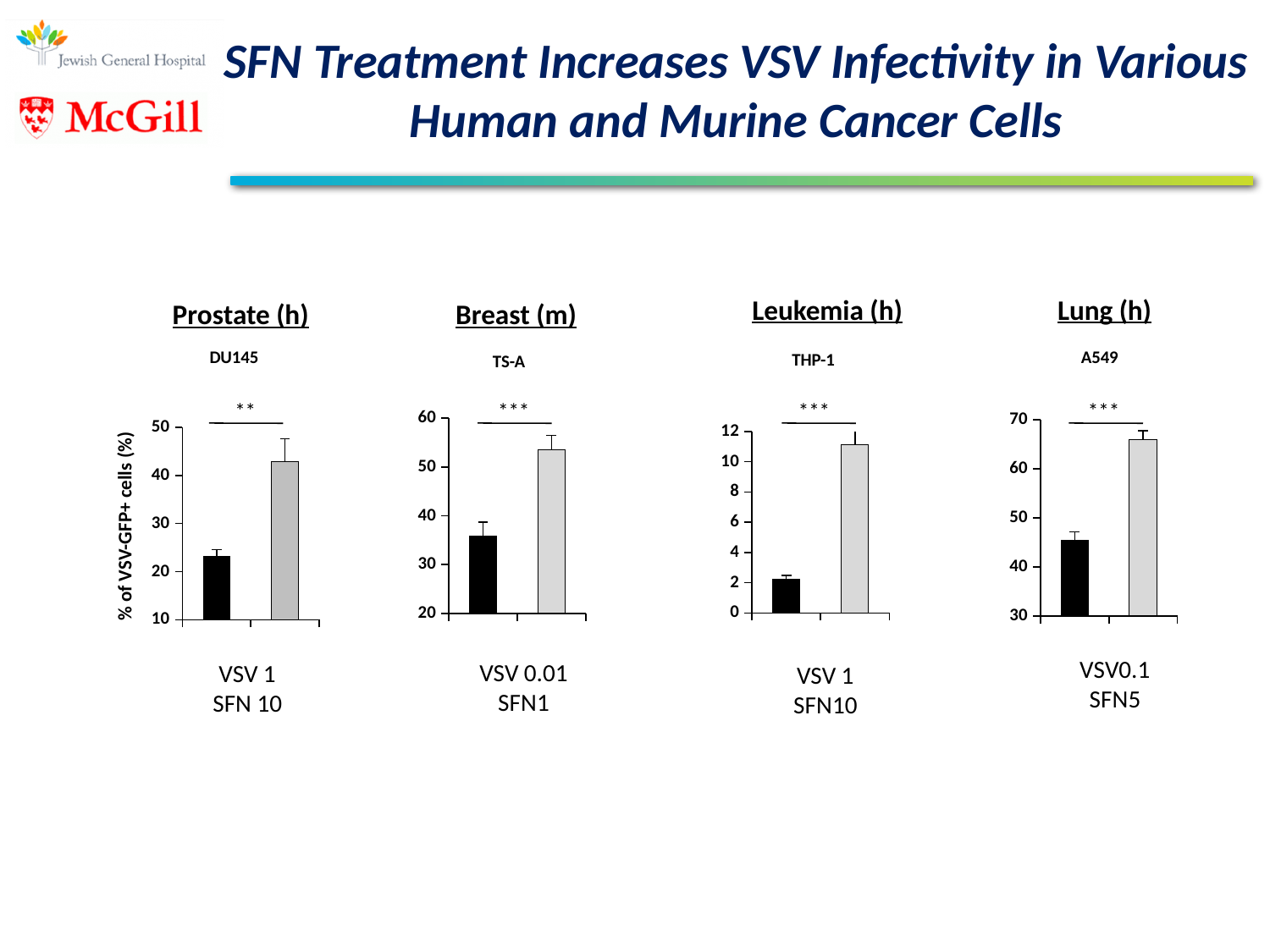
What is the y-axis label shown on the Prostate (h) DU145 chart? % of VSV-GFP+ cells (%) In the Lung (h) A549 chart, is the value of the grey bar greater or less than 60? greater How many bars are plotted in the Leukemia (h) THP-1 chart? 2 In the Prostate (h) DU145 chart, is the value of the black bar greater or less than 30? less What kind of chart is the Prostate (h) DU145 chart? bar chart In the Breast (m) TS-A chart, is the value of the grey bar greater or less than 50? greater Which cell line name is shown above the Lung (h) chart? A549 In the Prostate (h) DU145 chart, which bar is taller, the black bar or the grey bar? the grey bar